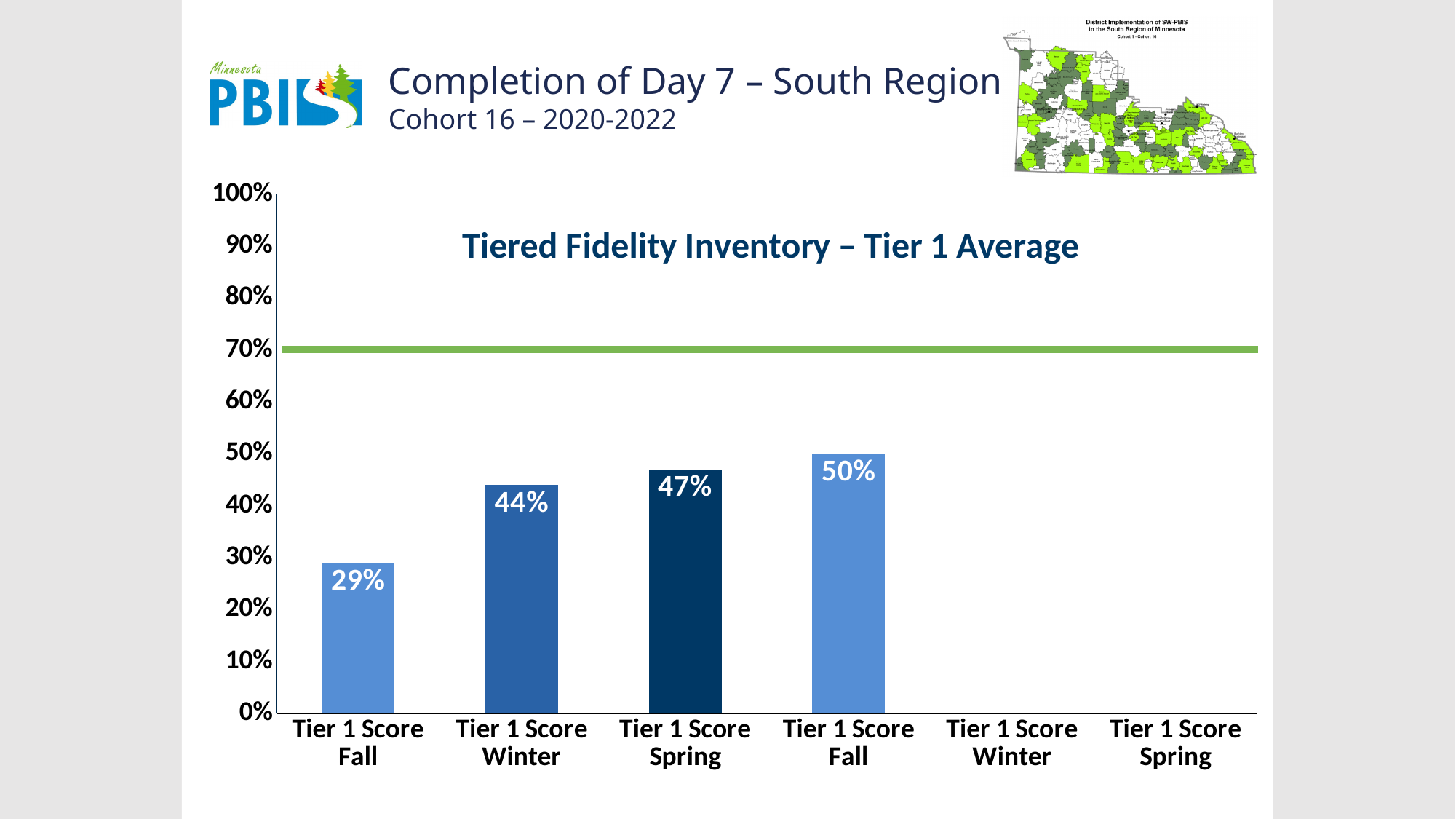
What is the value of the Tier 1 Score Winter bar? 44% What is the value of the Tier 1 Score Spring bar? 47% How many category labels are shown on the x axis? 6 What is the title of the chart? Tiered Fidelity Inventory – Tier 1 Average What is the value of the second Tier 1 Score Fall bar (the fourth bar)? 50% Do the plotted bar values rise or fall from left to right? rise Which is larger, the Tier 1 Score Winter bar or the first Tier 1 Score Fall bar? Tier 1 Score Winter What is the difference between the Tier 1 Score Spring bar and the Tier 1 Score Winter bar? 3% What is the value of the first Tier 1 Score Fall bar? 29% Which bar has the highest value? the second Tier 1 Score Fall bar (50%) What type of chart is shown on the slide? bar chart Which bar has the lowest value? the first Tier 1 Score Fall bar (29%)